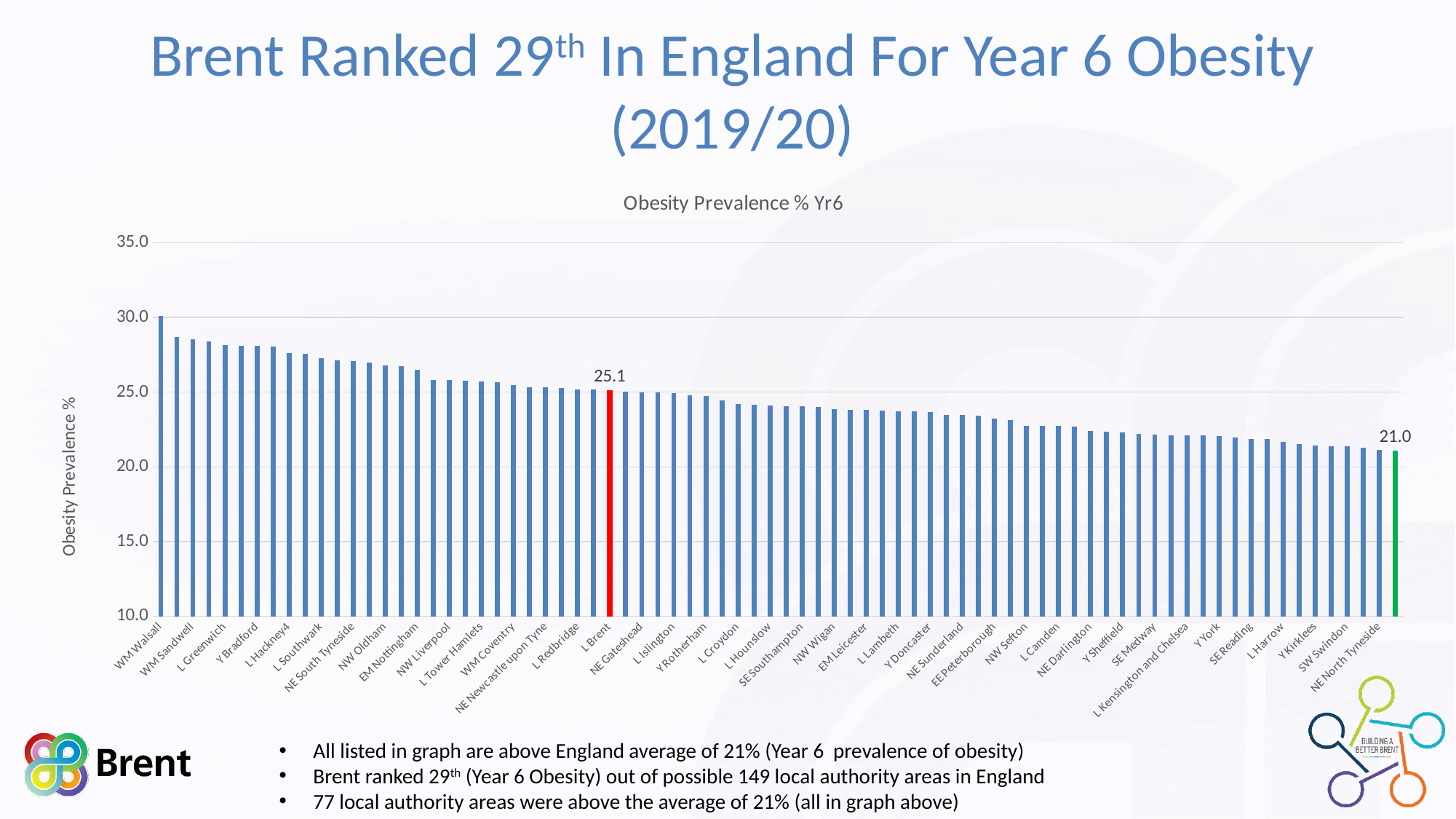
Do the bar values rise or fall from left to right across the chart? Fall What kind of chart is shown on the slide? Bar chart What colour is the bar for L Brent? Red What value is labelled on the green bar at the right end of the chart? 21.0 What is the title of the chart? Obesity Prevalence % Yr6 Which has a higher obesity prevalence, L Greenwich or NE Gateshead? L Greenwich Is the value for Y York greater or less than 25? less What is the difference between the L Brent value (25.1) and the green bar value (21.0)? 4.1 What is the Year 6 obesity prevalence value shown for L Brent? 25.1 Is the value for WM Walsall greater or less than 25? greater Which has a higher obesity prevalence, WM Walsall or L Brent? WM Walsall Which local authority has the highest obesity prevalence in the chart? WM Walsall